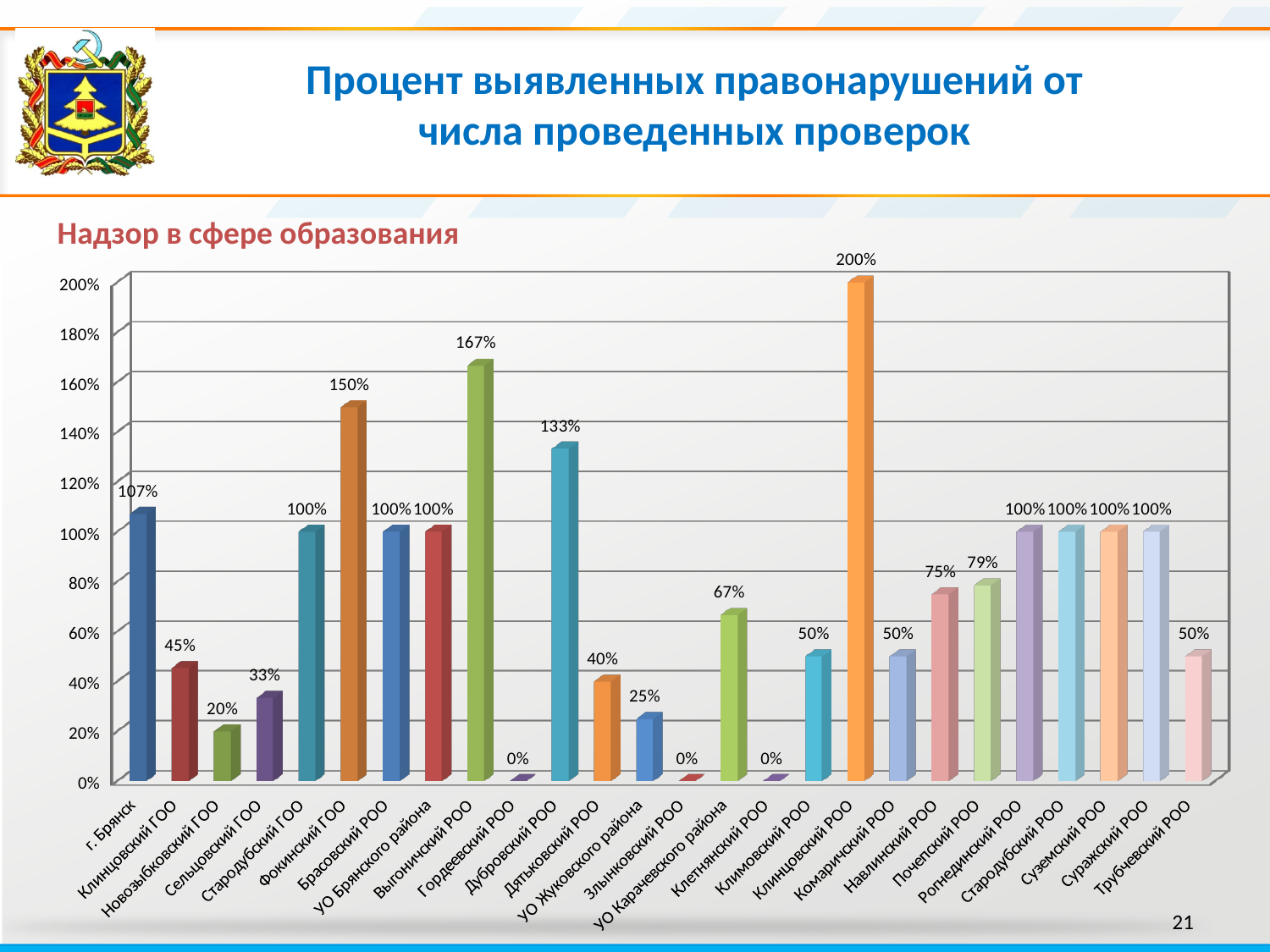
Which is larger, the value for Сельцовский ГОО or the value for Дятьковский РОО? Дятьковский РОО What is the value for Выгоничский РОО? 167% What is the value for г. Брянск? 107% What is the difference between the values for Клинцовский ГОО and Новозыбковский ГОО? 25% What is the title of the chart on the slide? Процент выявленных правонарушений от числа проведенных проверок What is the value for УО Жуковского района? 25% What kind of chart is shown on the slide? Bar chart What is the value for Почепский РОО? 79% How many categories are shown on the x axis? 26 Which category has the highest value? Клинцовский РОО Which is larger, the value for Навлинский РОО or the value for УО Карачевского района? Навлинский РОО What is the difference between the values for Фокинский ГОО and Дубровский РОО? 17%